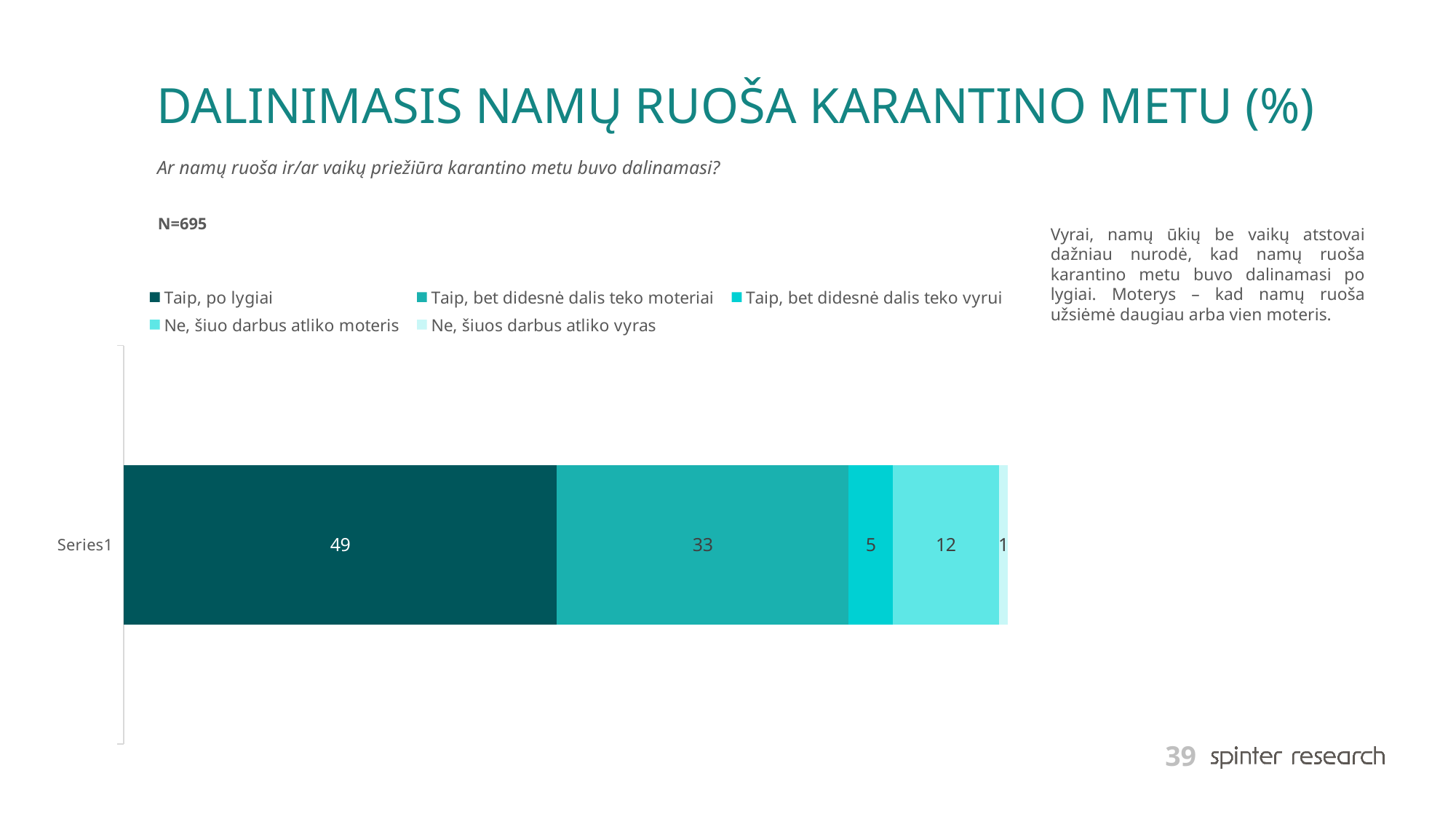
Which legend entry has the lowest value? Ne, šiuos darbus atliko vyras Which legend entry has the highest value? Taip, po lygiai What is the value for "Taip, po lygiai"? 49 Which is larger: the value for "Ne, šiuo darbus atliko moteris" or the value for "Taip, bet didesnė dalis teko vyrui"? Ne, šiuo darbus atliko moteris What kind of chart is shown on the slide? Stacked bar chart What is the difference between the values for "Taip, po lygiai" and "Taip, bet didesnė dalis teko moteriai"? 16 What is the value for "Taip, bet didesnė dalis teko moteriai"? 33 What is the value for "Ne, šiuos darbus atliko vyras"? 1 What is the value for "Taip, bet didesnė dalis teko vyrui"? 5 How many series does the legend list? 5 What is the total of the stacked bar? 100 What is the value for "Ne, šiuo darbus atliko moteris"? 12